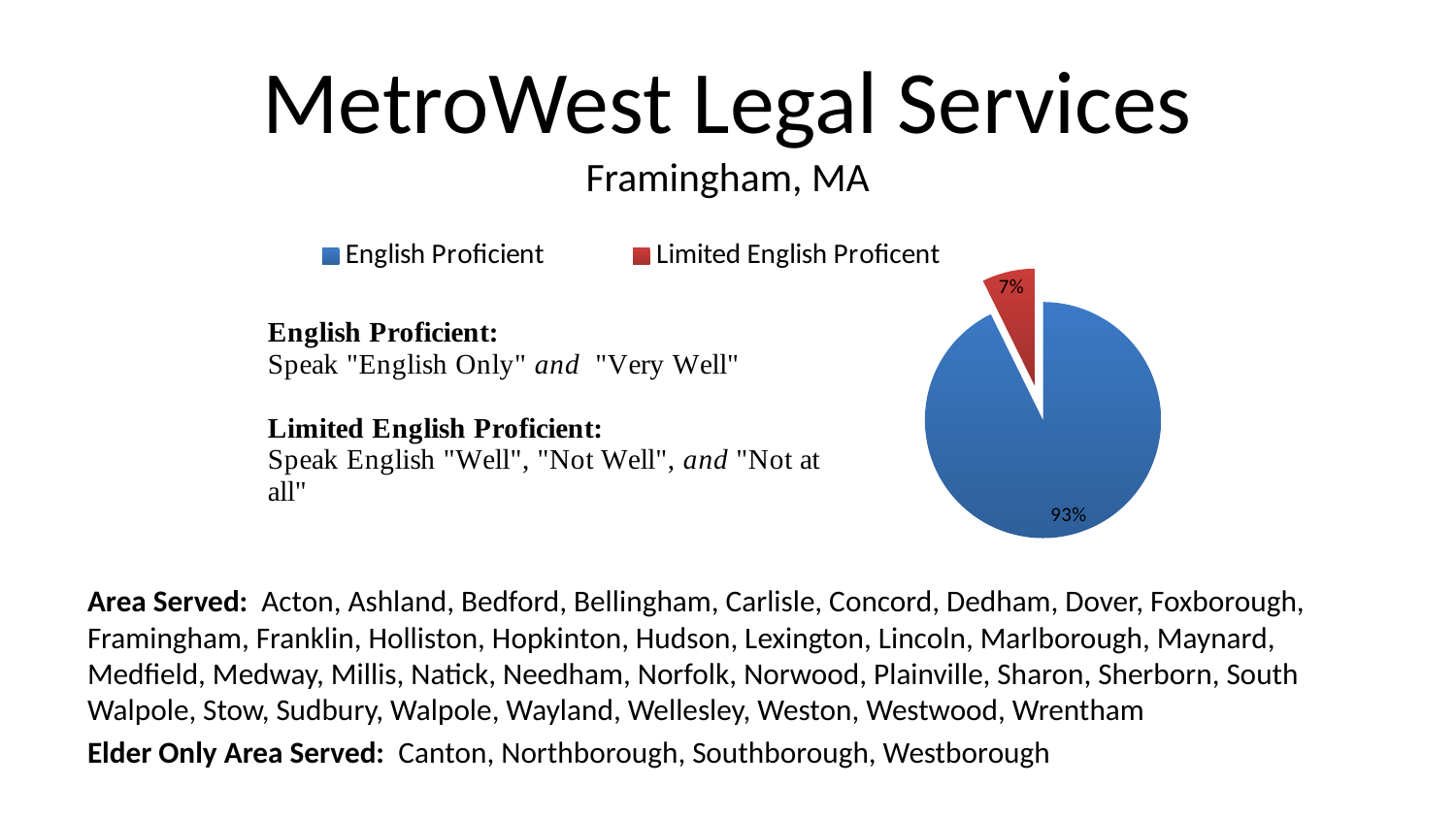
Which category has the smallest slice of the pie? Limited English Proficent What share of the pie is labelled Limited English Proficent? 7% How many entries does the legend list? 2 What share of the pie is labelled English Proficient? 93% Which category has the largest slice of the pie? English Proficient What colour is the English Proficient slice? Blue How many slices does the pie chart have? 2 What kind of chart is shown on the slide? Pie chart What is the difference in percentage points between the English Proficient and Limited English Proficent slices? 86 Which is larger, the English Proficient slice or the Limited English Proficent slice? English Proficient What colour is the Limited English Proficent slice? Red